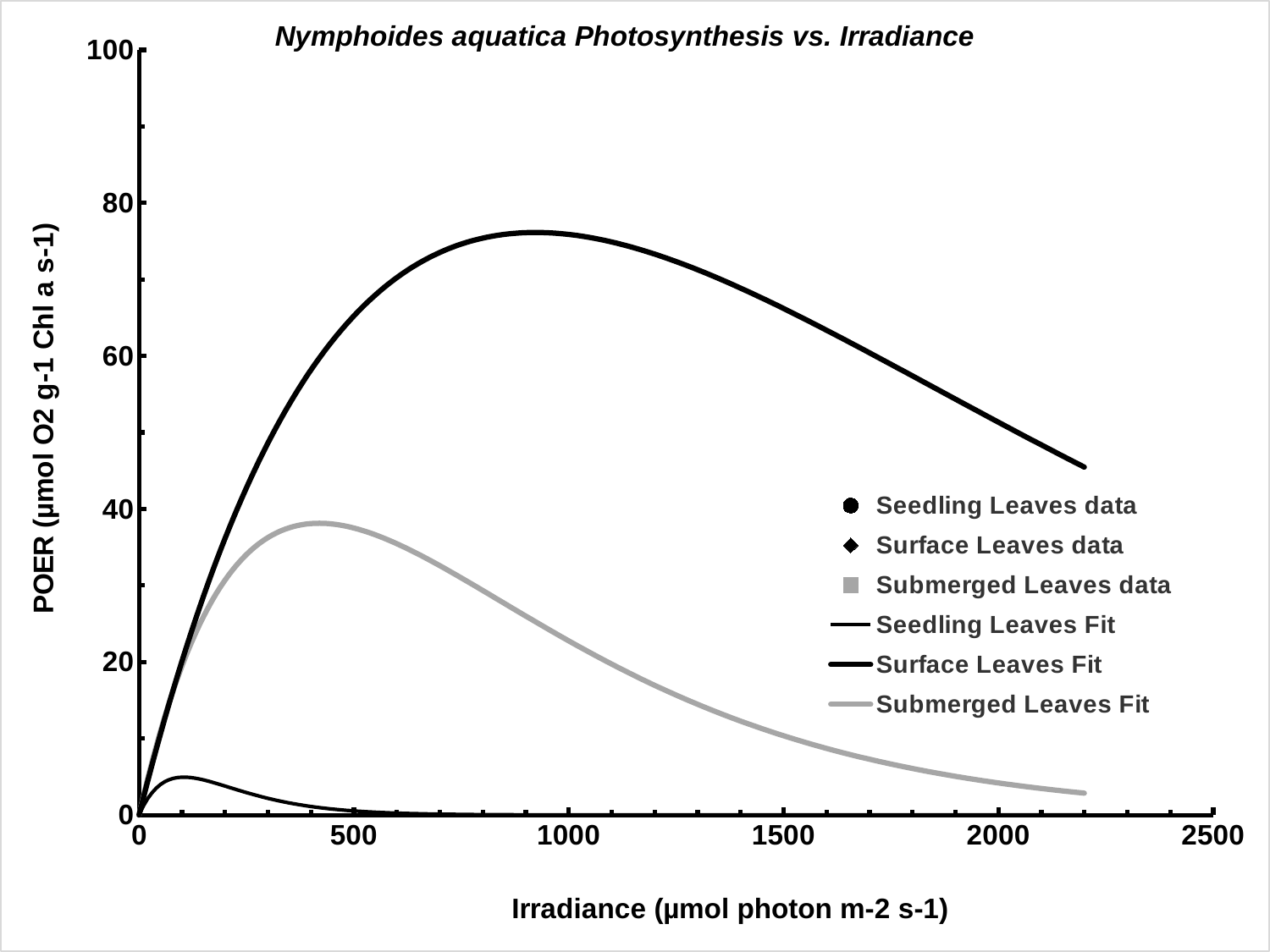
What kind of chart is shown on the slide? line chart What is the title of the chart? Nymphoides aquatica Photosynthesis vs. Irradiance Which fit curve stays lowest across the irradiance range? Seedling Leaves Fit Is the peak value of the Surface Leaves Fit curve greater or less than 60? greater Is the value of the Surface Leaves Fit curve at an irradiance of 2000 greater or less than 40? greater What is the label of the x axis? Irradiance (µmol photon m-2 s-1) Is the peak value of the Seedling Leaves Fit curve greater or less than 20? less At an irradiance of 1000, which curve is higher: Surface Leaves Fit or Submerged Leaves Fit? Surface Leaves Fit Does the Submerged Leaves Fit curve rise or fall as irradiance increases from 500 to 2000? fall How many entries does the legend list? 6 Which fit curve reaches the highest POER value? Surface Leaves Fit